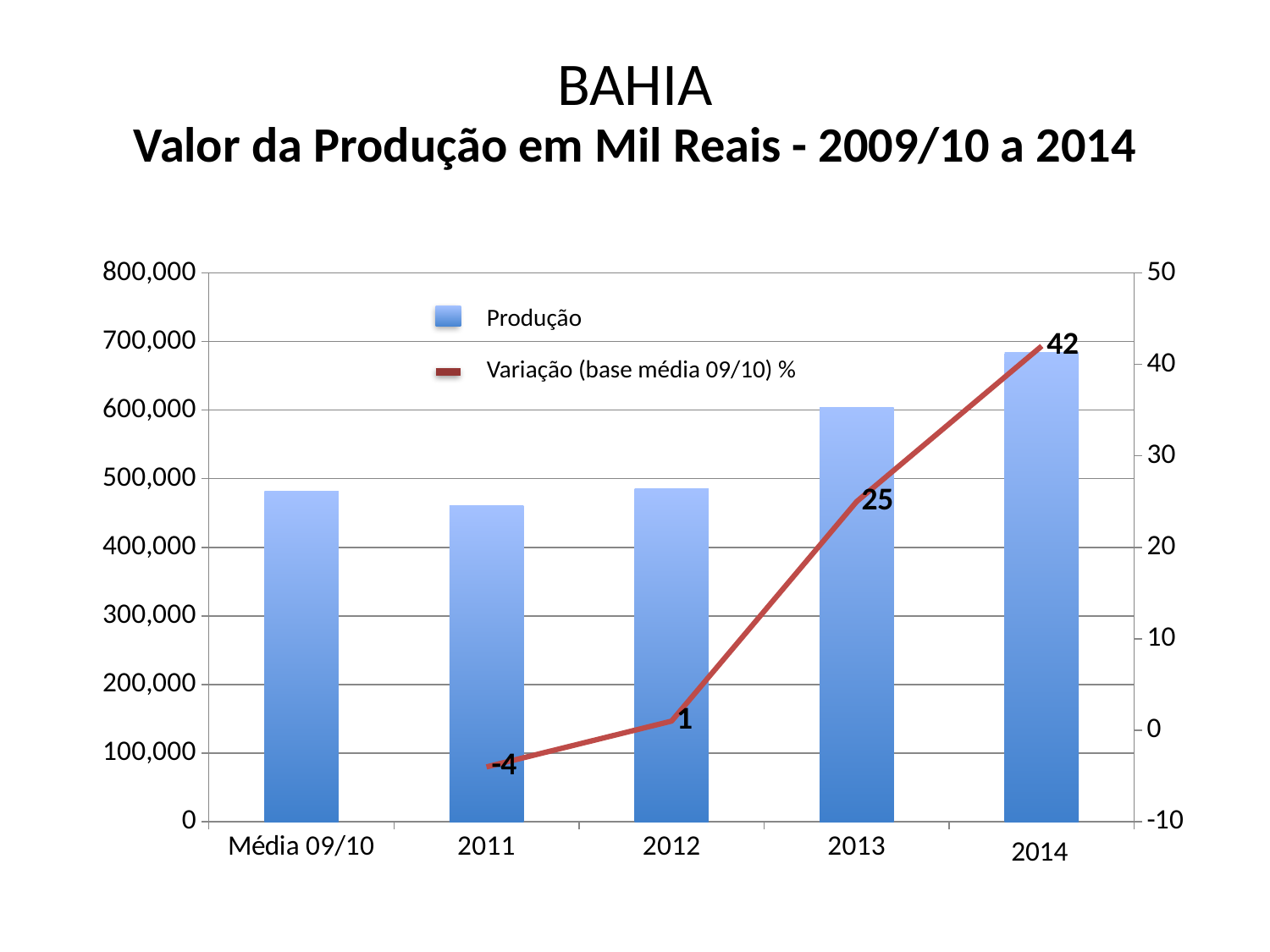
Is the Produção value for 2014 greater or less than 600,000? greater What is the Variação (base média 09/10) % value for 2013? 25 Does the Variação (base média 09/10) % line rise or fall from 2011 to 2014? rises What is the Variação (base média 09/10) % value for 2014? 42 How many categories are shown on the x axis? 5 What is the Variação (base média 09/10) % value for 2012? 1 Which category has the lowest Produção bar? 2011 Which has a larger Produção value, 2013 or 2012? 2013 What is the difference between the Variação values for 2014 and 2013? 17 How many series does the legend list? 2 Which year has the highest Produção bar? 2014 What is the Variação (base média 09/10) % value for 2011? -4